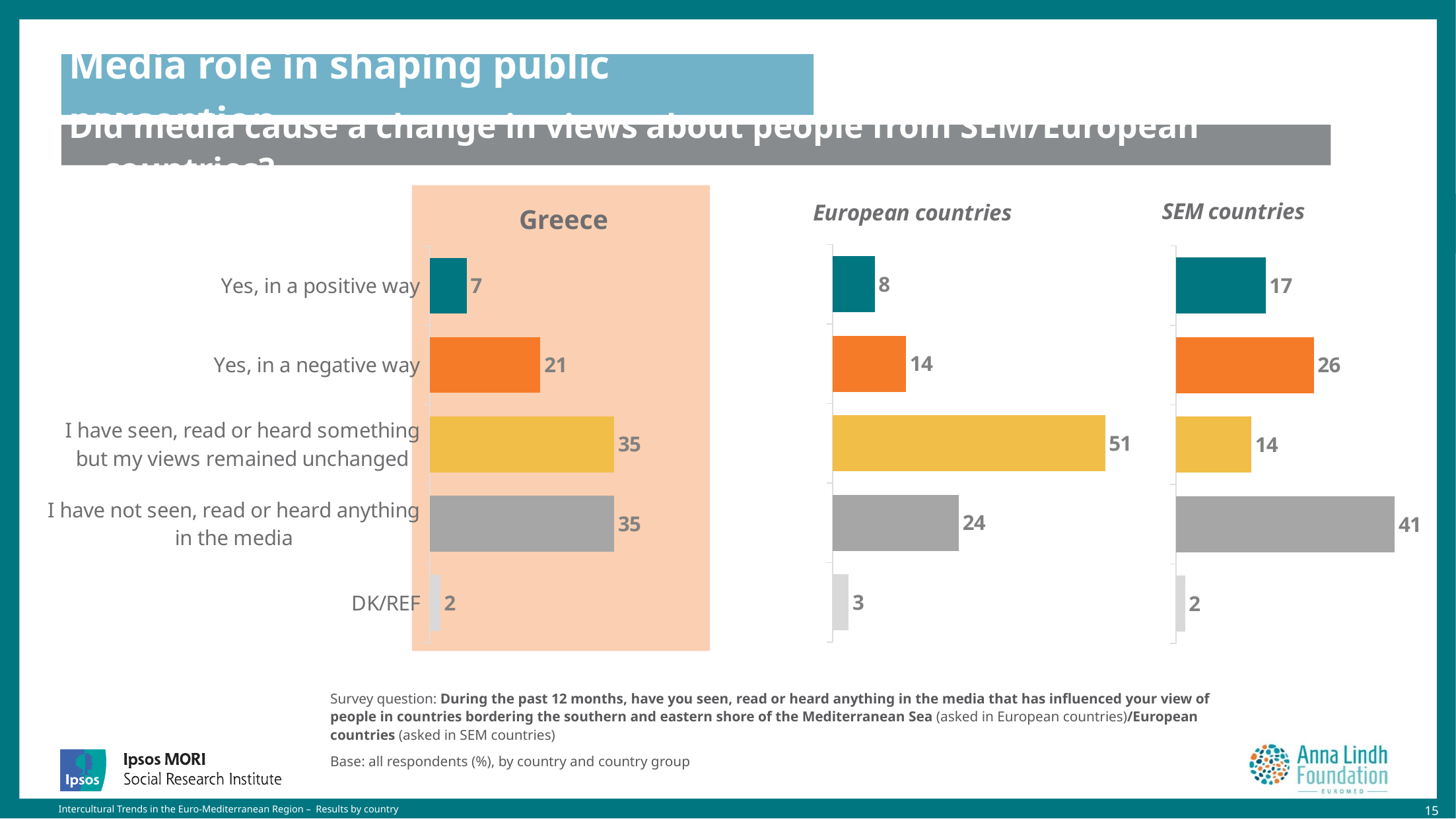
In the SEM countries chart, what is the value for "Yes, in a positive way"? 17 In the European countries chart, what is the value for "I have seen, read or heard something but my views remained unchanged"? 51 How many categories are shown in the Greece chart? 5 Which is larger: the value for "Yes, in a negative way" in the Greece chart or in the SEM countries chart? SEM countries In the Greece chart, what is the value for "Yes, in a negative way"? 21 In the European countries chart, which category has the lowest value? DK/REF Which of the three charts is highlighted with a shaded background? Greece In the SEM countries chart, which category has the highest value? I have not seen, read or heard anything in the media In the European countries chart, what is the value for DK/REF? 3 What type of chart is used for the Greece data? Bar chart In the Greece chart, what is the difference between "Yes, in a negative way" and "Yes, in a positive way"? 14 In the SEM countries chart, what is the difference between "I have not seen, read or heard anything in the media" and "Yes, in a negative way"? 15